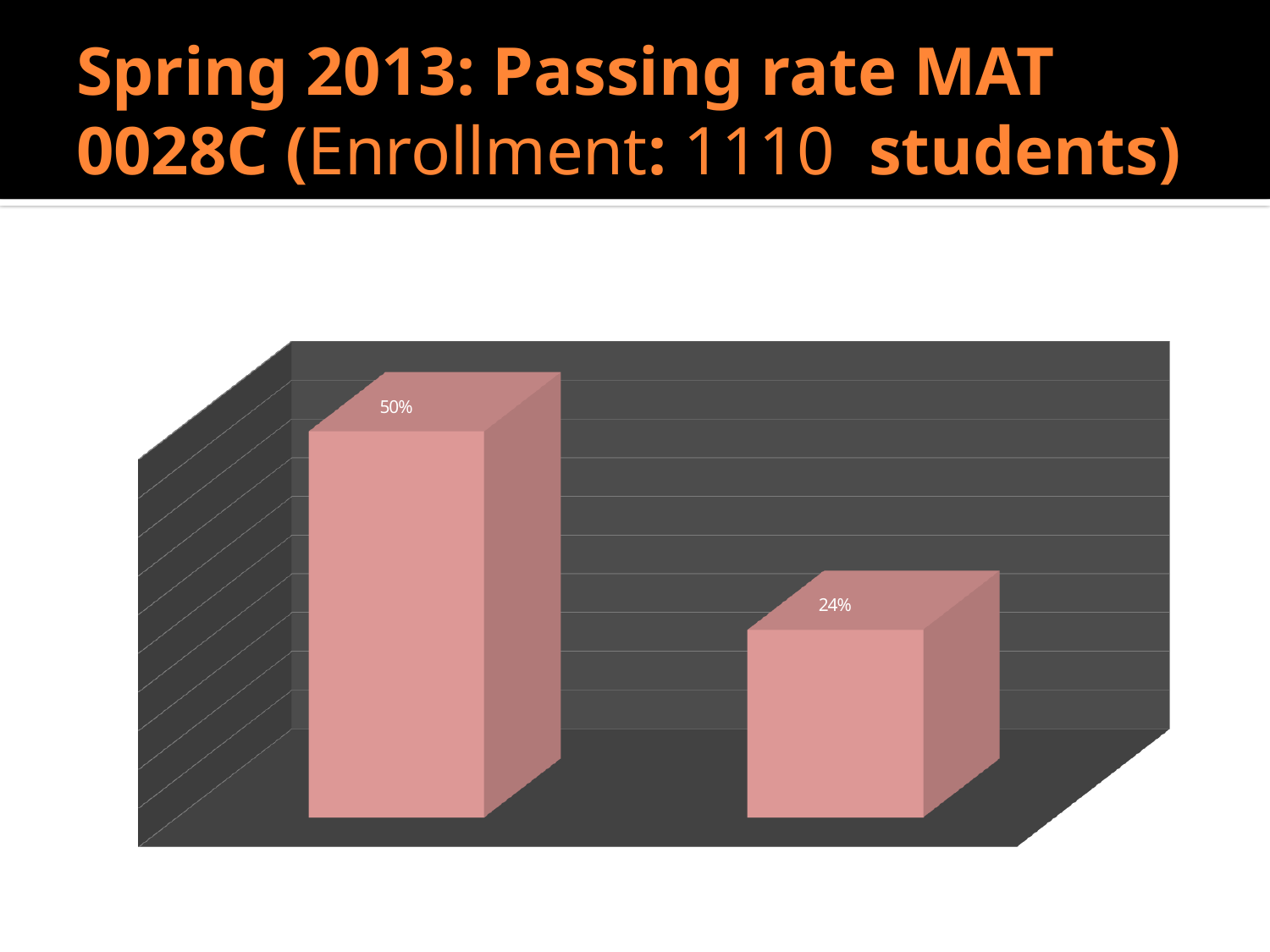
Do the bar values rise or fall from left to right? fall What enrollment figure is stated in the slide title? 1110 students What is the lowest value shown in the chart? 24% What is the title of the slide containing the chart? Spring 2013: Passing rate MAT 0028C (Enrollment: 1110 students) How many bars are plotted in the chart? 2 What value is labelled on the left bar of the chart? 50% What value is labelled on the right bar of the chart? 24% What is the difference between the left bar's value and the right bar's value? 26% What is the highest value shown in the chart? 50% Which bar is taller, the left bar or the right bar? the left bar What kind of chart is shown on the slide? bar chart